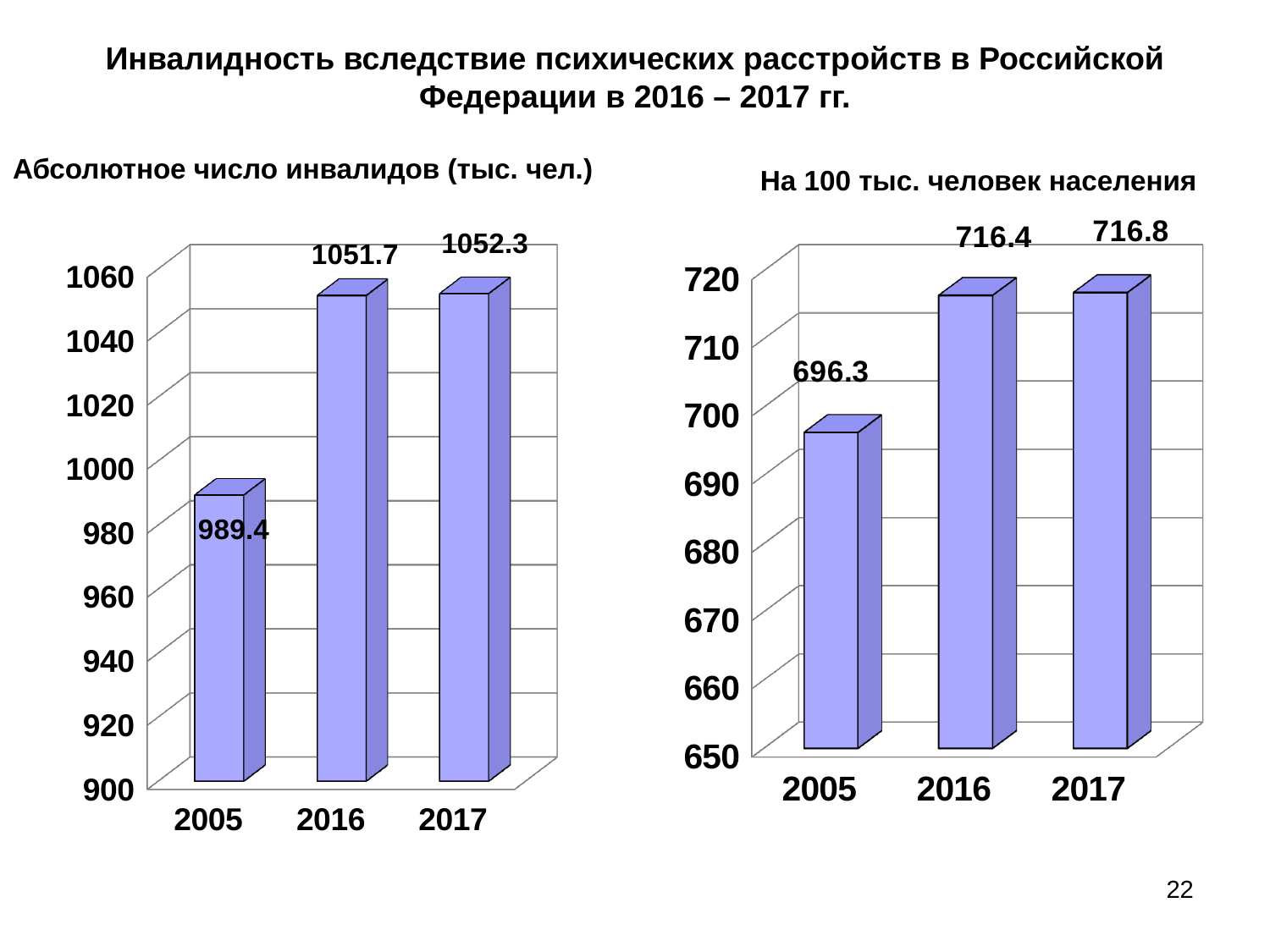
In the right chart (На 100 тыс. человек населения), which year has the lowest value? 2005 In the left chart (Абсолютное число инвалидов), is the value for 2005 greater or less than 1000? less In the right chart (На 100 тыс. человек населения), what is the value for 2005? 696.3 In the right chart (На 100 тыс. человек населения), what is the value for 2016? 716.4 In the left chart (Абсолютное число инвалидов), what is the value for 2017? 1052.3 What type of chart is the left chart (Абсолютное число инвалидов)? bar chart In the left chart (Абсолютное число инвалидов), what is the difference between the values for 2016 and 2005? 62.3 In the right chart (На 100 тыс. человек населения), what is the difference between the values for 2017 and 2005? 20.5 How many years are shown on the x axis of the right chart (На 100 тыс. человек населения)? 3 In the right chart (На 100 тыс. человек населения), do the values rise or fall from 2005 to 2017? rise In the left chart (Абсолютное число инвалидов), what is the value for 2005? 989.4 In the left chart (Абсолютное число инвалидов), which year has the lowest value? 2005